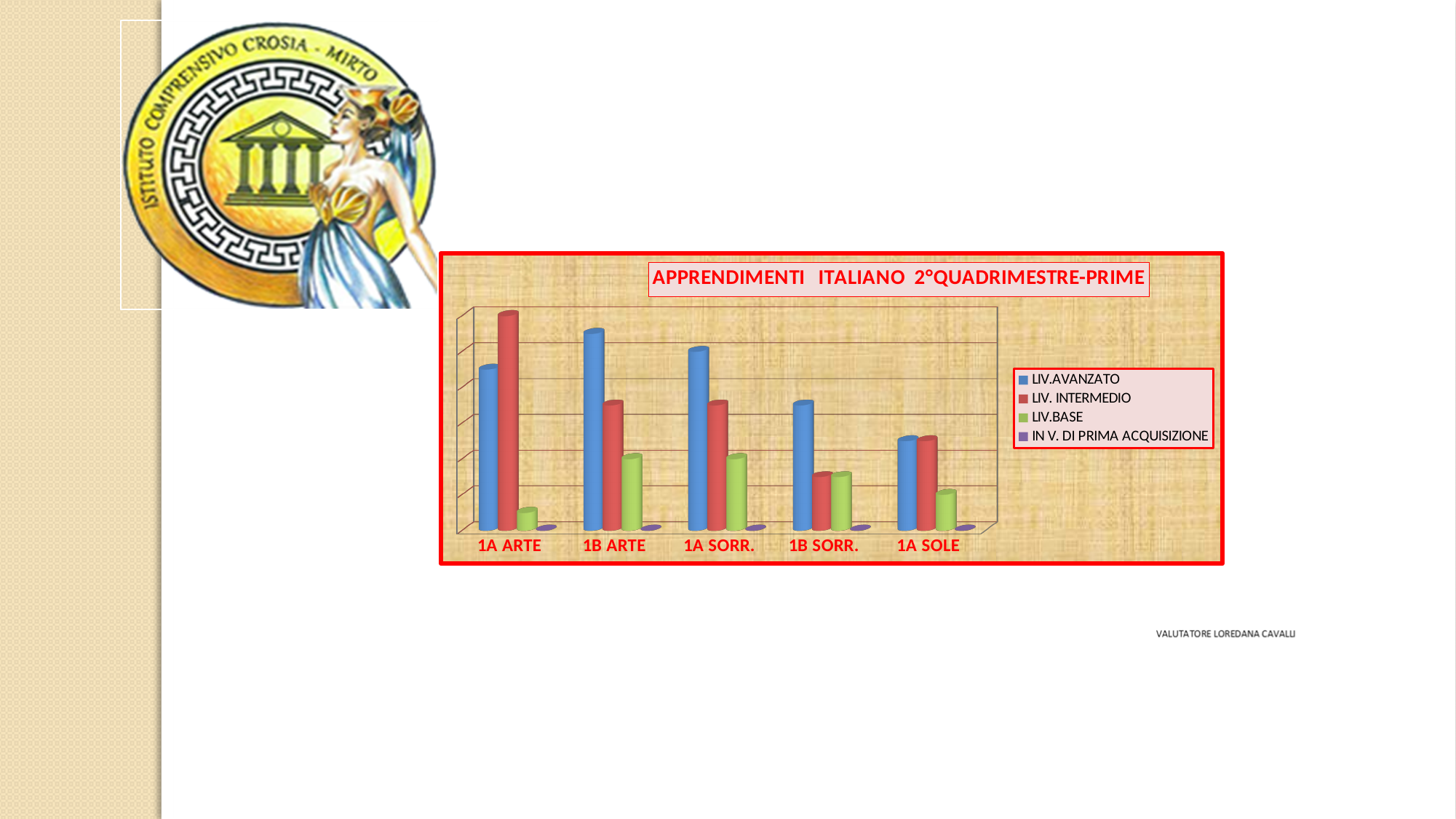
How many series does the chart legend list? 4 What kind of chart is shown on the slide? Bar chart How many classes (categories) are shown on the x axis of the chart? 5 Which series is shown in green in the chart? LIV.BASE Which class has the tallest LIV. INTERMEDIO bar? 1A ARTE Which class has the shortest LIV.AVANZATO bar? 1A SOLE Which class has the tallest LIV.AVANZATO bar? 1B ARTE For 1A ARTE, which is larger: LIV.AVANZATO or LIV. INTERMEDIO? LIV. INTERMEDIO From 1B ARTE to 1A SOLE, do the LIV.AVANZATO bars rise or fall along the x axis? Fall Which class has the shortest LIV.BASE bar? 1A ARTE For 1A SORR., which is larger: LIV.AVANZATO or LIV. INTERMEDIO? LIV.AVANZATO What is the title of the chart? APPRENDIMENTI ITALIANO 2°QUADRIMESTRE-PRIME